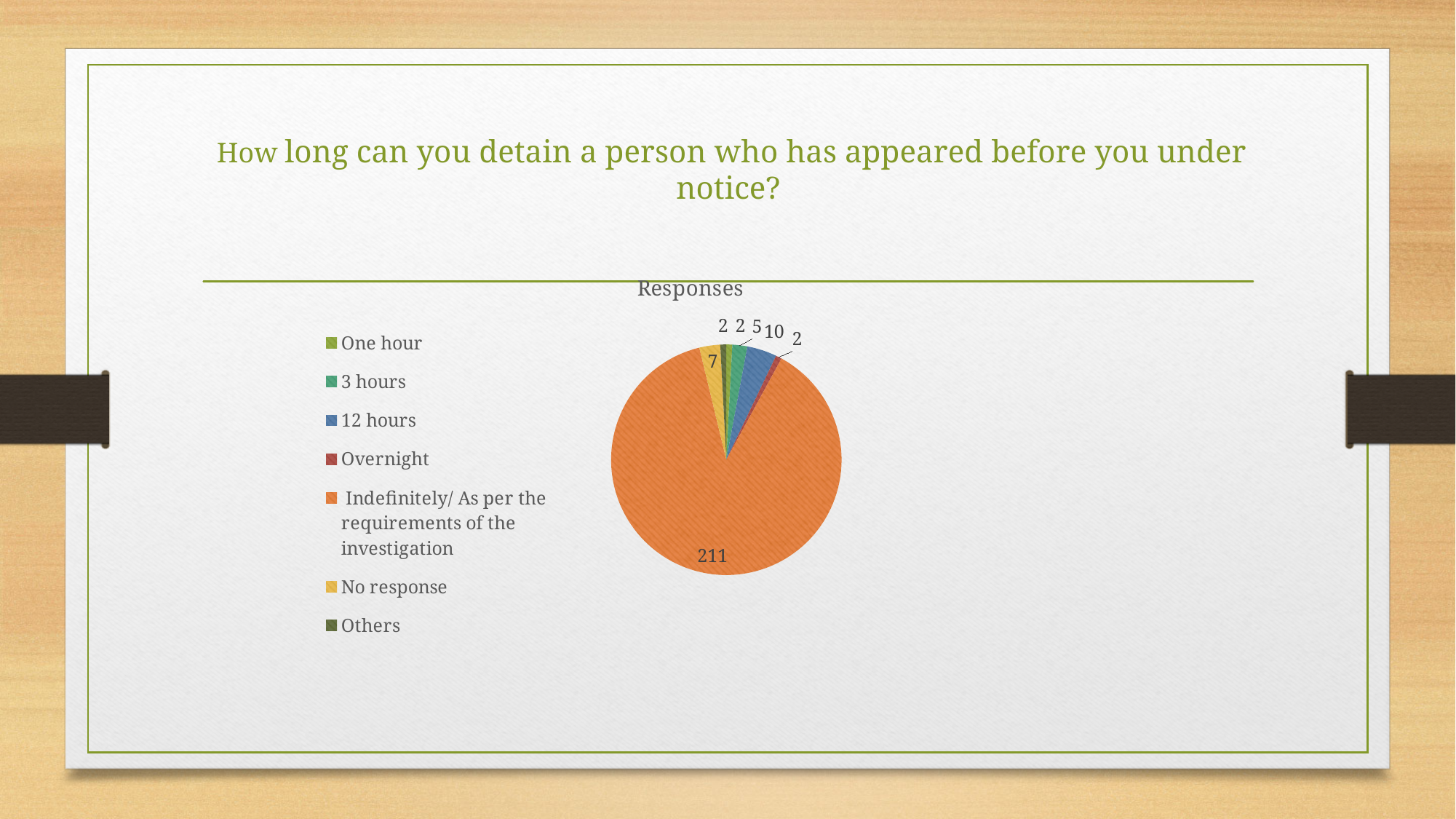
What is the value for '12 hours'? 10 How many categories does the legend list? 7 What is the difference between the values for '12 hours' and 'No response'? 3 What is the value for 'No response'? 7 What is the title of the chart? Responses What is the value for 'Indefinitely/ As per the requirements of the investigation'? 211 What kind of chart is shown on the slide? pie chart What is the value for 'Overnight'? 2 What is the total of all the values shown on the pie chart? 239 Which category has the largest slice? Indefinitely/ As per the requirements of the investigation What is the value for '3 hours'? 5 Which is larger, '12 hours' or '3 hours'? 12 hours